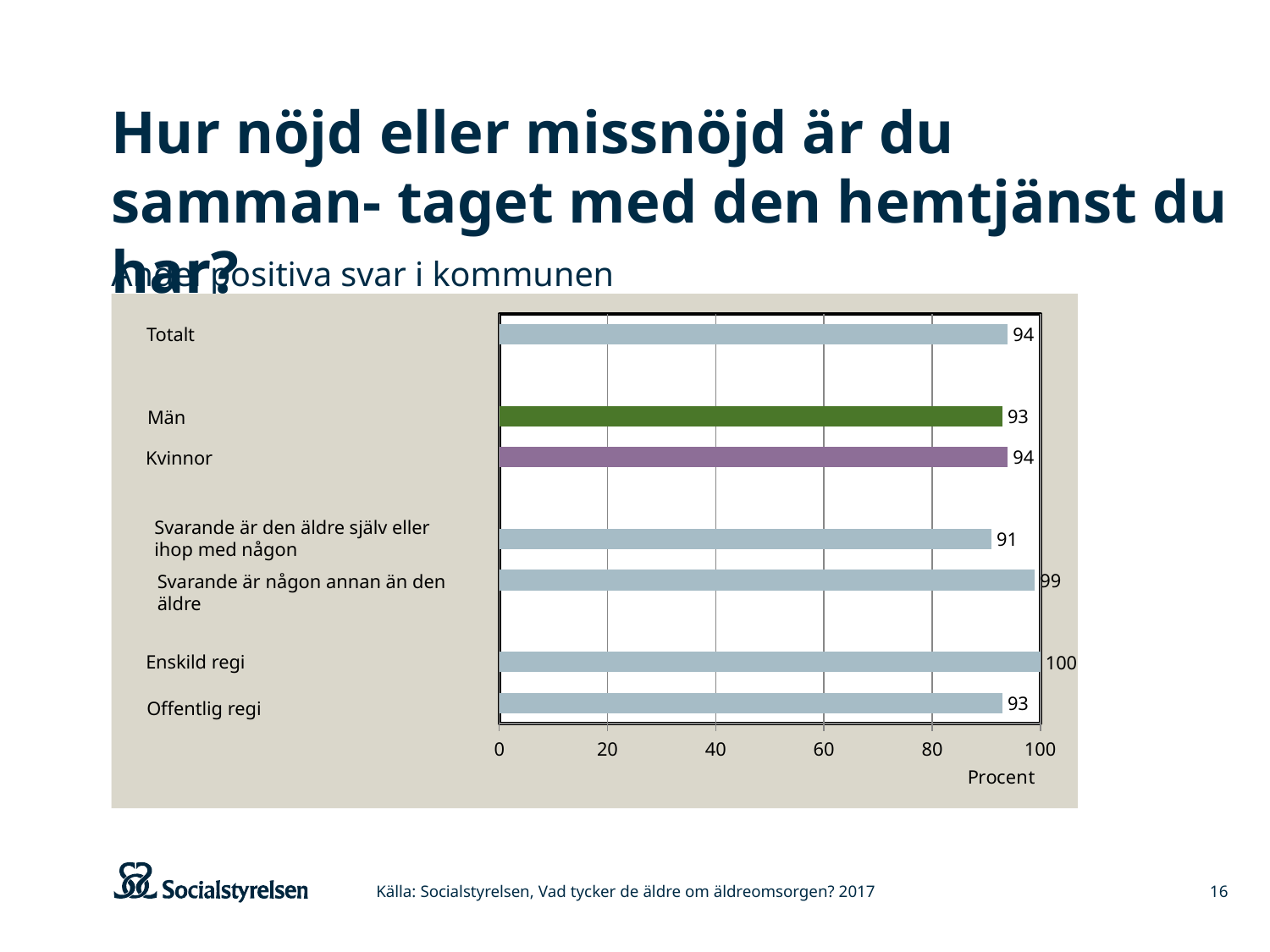
What is the difference between Enskild regi and Offentlig regi? 7 What is the value for Totalt? 94 What is the label of the horizontal axis? Procent What is the value for Svarande är någon annan än den äldre? 99 How many categories are shown in the chart? 7 What is the value for Enskild regi? 100 What is the difference between Svarande är någon annan än den äldre and Svarande är den äldre själv eller ihop med någon? 8 What is the value for Män? 93 Which category has the highest value? Enskild regi Which category has the lowest value? Svarande är den äldre själv eller ihop med någon What kind of chart is shown on the slide? bar chart Which is larger, the value for Kvinnor or the value for Män? Kvinnor